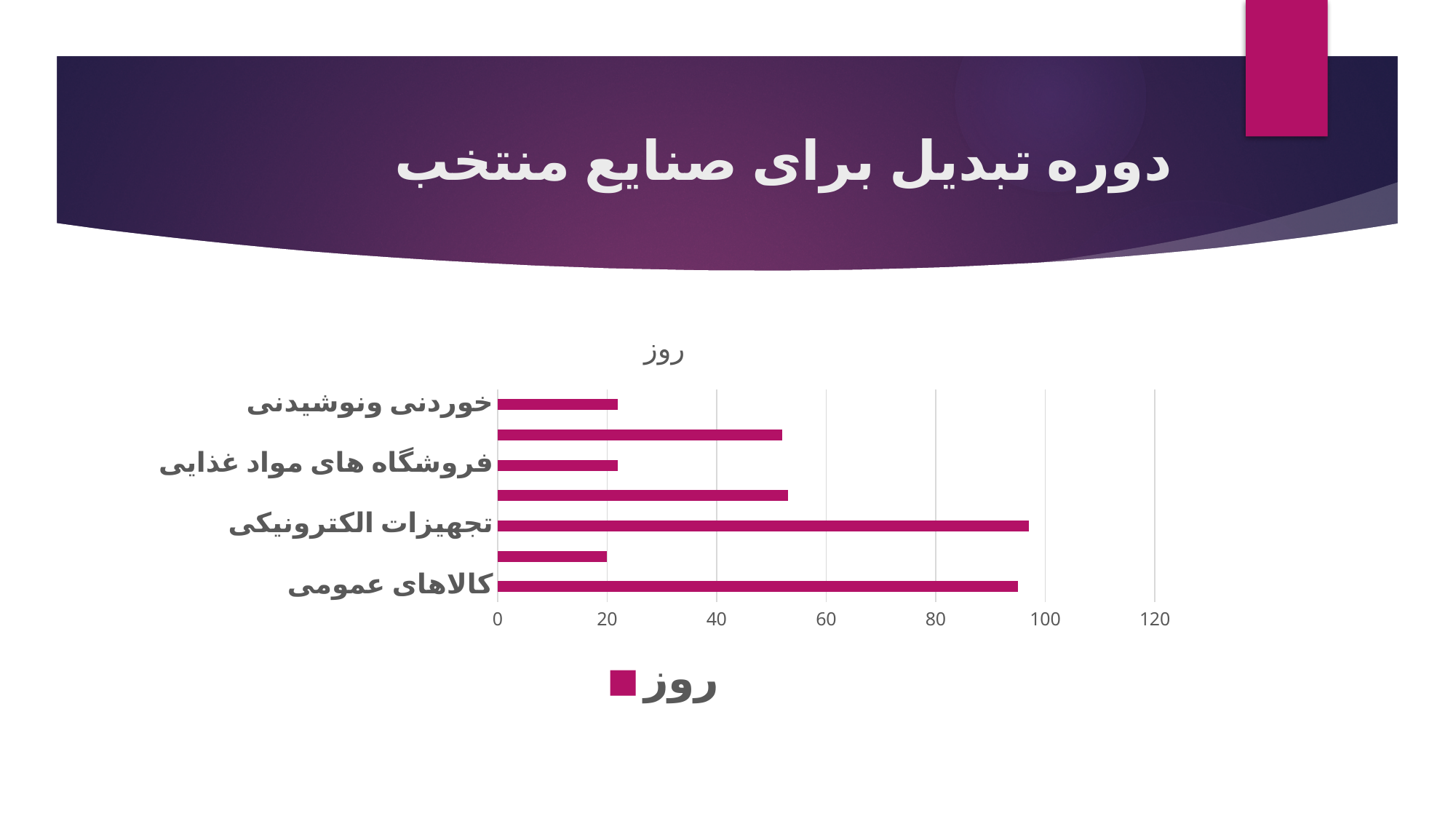
Is the value for تجهیزات الکترونیکی greater or less than 80? greater Is the value for کالاهای عمومی greater or less than 80? greater What kind of chart is shown on the slide? bar chart Which is larger, the value for کالاهای عمومی or the value for فروشگاه های مواد غذایی? کالاهای عمومی How many series does the legend list? 1 Which is larger, the value for تجهیزات الکترونیکی or the value for خوردنی ونوشیدنی? تجهیزات الکترونیکی Is the value for فروشگاه های مواد غذایی greater or less than 40? less What is the title of the chart? روز How many bars are plotted in the chart? 7 What is the legend entry shown below the chart? روز